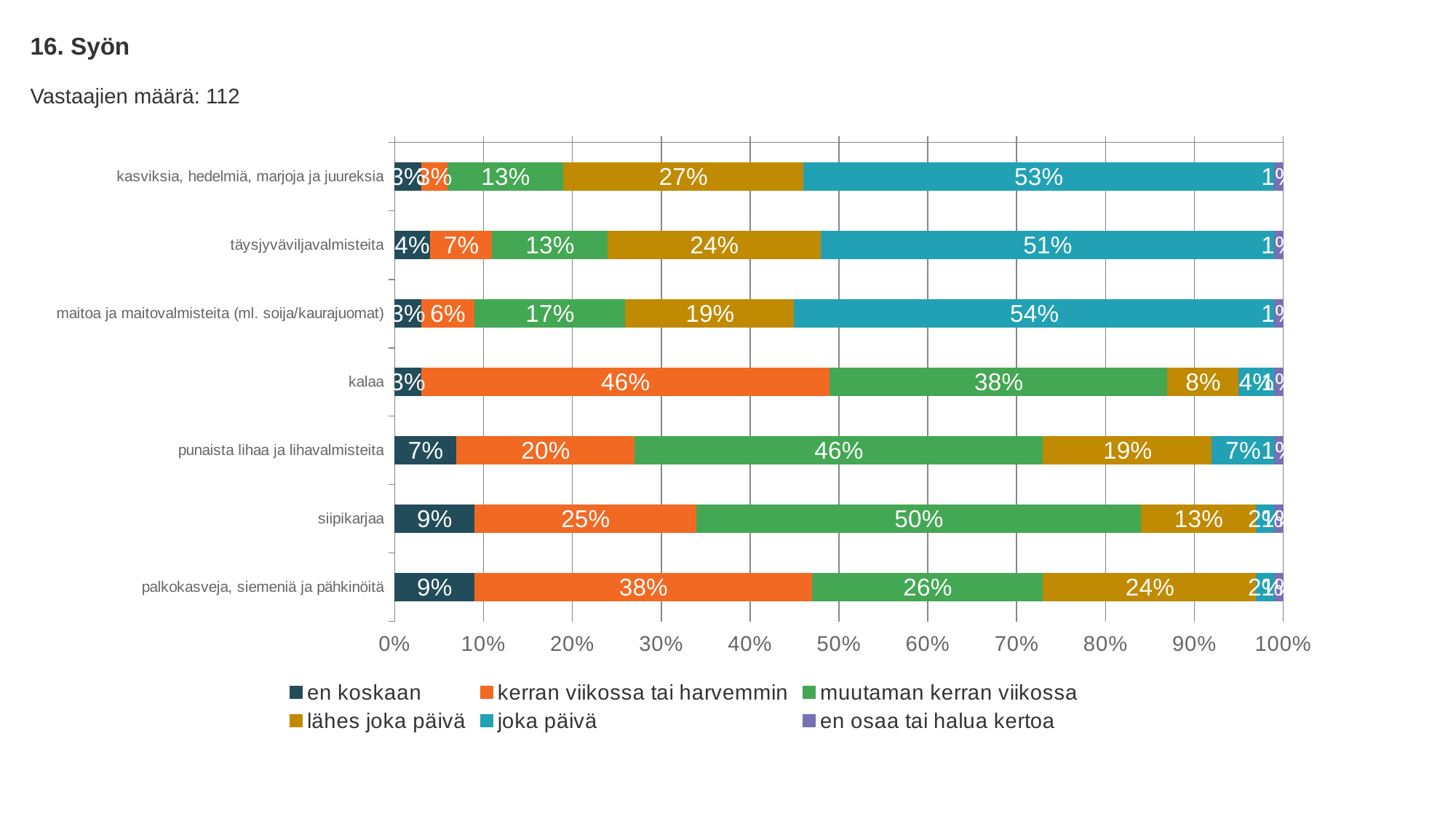
What is the 'kerran viikossa tai harvemmin' value for 'kalaa'? 46% What is the 'muutaman kerran viikossa' value for 'siipikarjaa'? 50% Which category has the highest 'muutaman kerran viikossa' value? siipikarjaa What is the 'muutaman kerran viikossa' value for 'maitoa ja maitovalmisteita (ml. soija/kaurajuomat)'? 17% What is the 'lähes joka päivä' value for 'täysjyväviljavalmisteita'? 24% What kind of chart is shown on the slide? Stacked bar chart Which is larger: the 'lähes joka päivä' value for 'kasviksia, hedelmiä, marjoja ja juureksia' or for 'täysjyväviljavalmisteita'? kasviksia, hedelmiä, marjoja ja juureksia How many food categories are listed on the vertical axis? 7 What is the difference between the 'kerran viikossa tai harvemmin' values for 'kalaa' and 'palkokasveja, siemeniä ja pähkinöitä'? 8% What is the 'joka päivä' value for 'kasviksia, hedelmiä, marjoja ja juureksia'? 53% How many series does the legend list? 6 Which category has the highest 'kerran viikossa tai harvemmin' value? kalaa